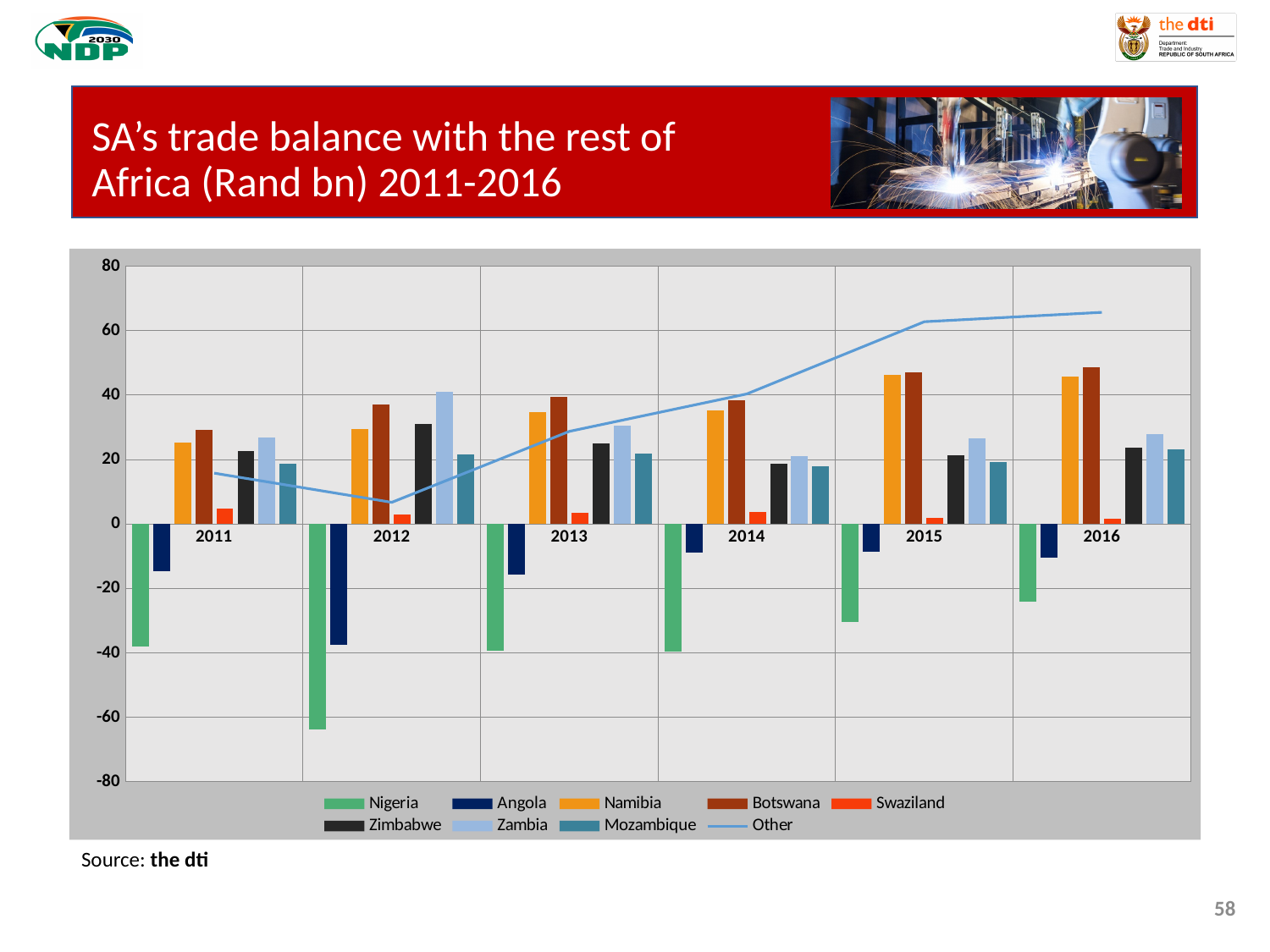
Which series is plotted as a line rather than bars? Other Which is larger, the Zambia value in 2012 or the Zambia value in 2014? 2012 In which year is the Nigeria value lowest? 2012 Is the value for the Other line in 2016 greater or less than 60? greater Which series has the lowest bar in 2012? Nigeria How many series does the legend list? 9 Is the value for Botswana in 2015 greater or less than 40? greater Is the value for Nigeria in 2012 greater or less than -60? less Does the Other line rise or fall from 2012 to 2016? rise How many years are shown on the x axis? 6 What kind of chart is shown on the slide? bar chart (with a line series)